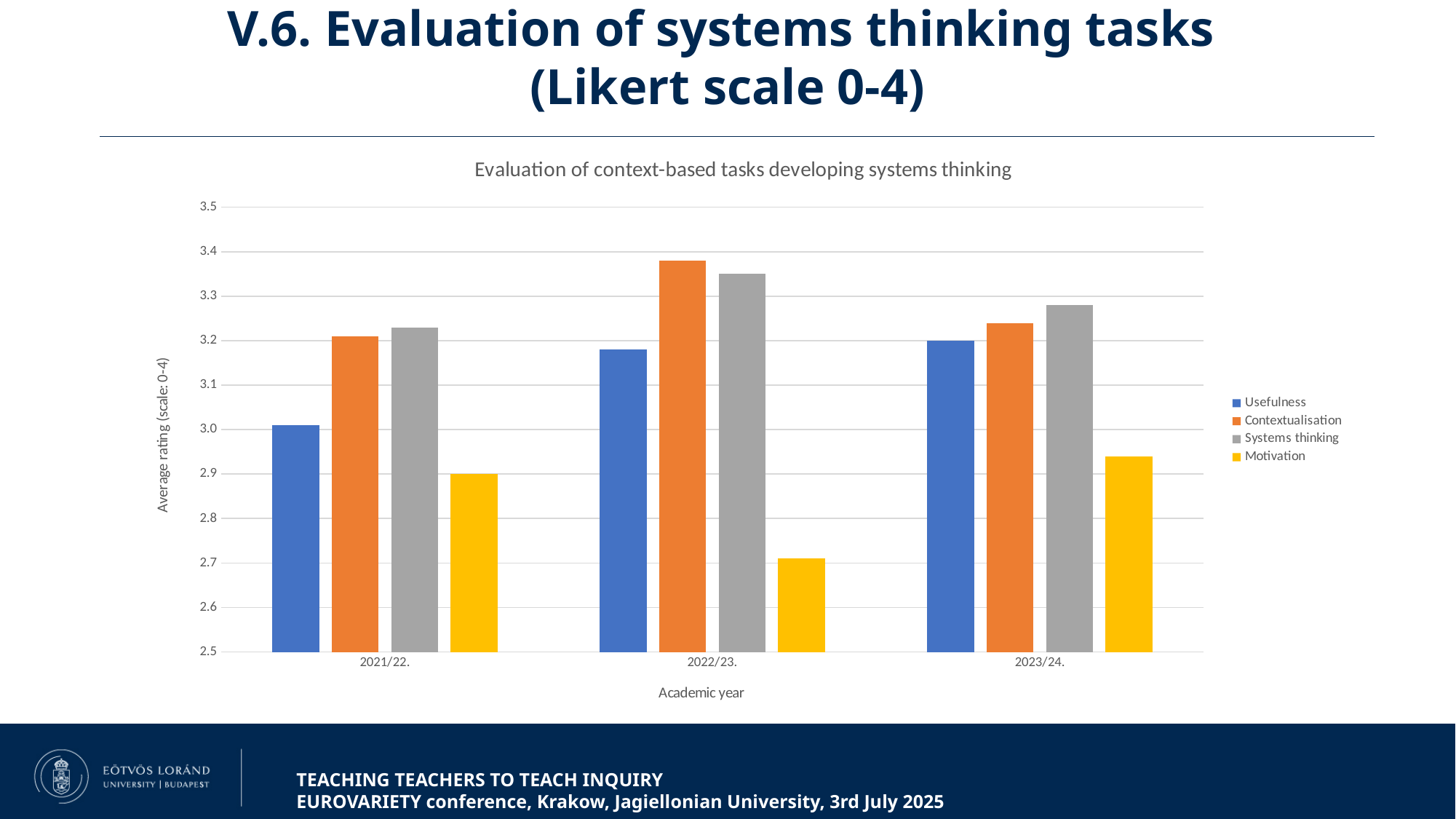
How many academic years are shown on the x axis? 3 Is the value for Motivation in 2022/23 greater or less than 2.8? less Which series has the lowest value in every academic year shown? Motivation Which series has the lowest value in 2022/23? Motivation Does the Usefulness value rise or fall from 2021/22 to 2023/24? rise Is the value for Usefulness in 2021/22 greater or less than 3.1? less Is the value for Contextualisation in 2022/23 greater or less than 3.3? greater Which is larger, the Motivation value for 2021/22 or for 2022/23? 2021/22 What is the label on the vertical axis of the chart? Average rating (scale: 0-4) How many series does the legend list? 4 What kind of chart is shown on the slide? bar chart